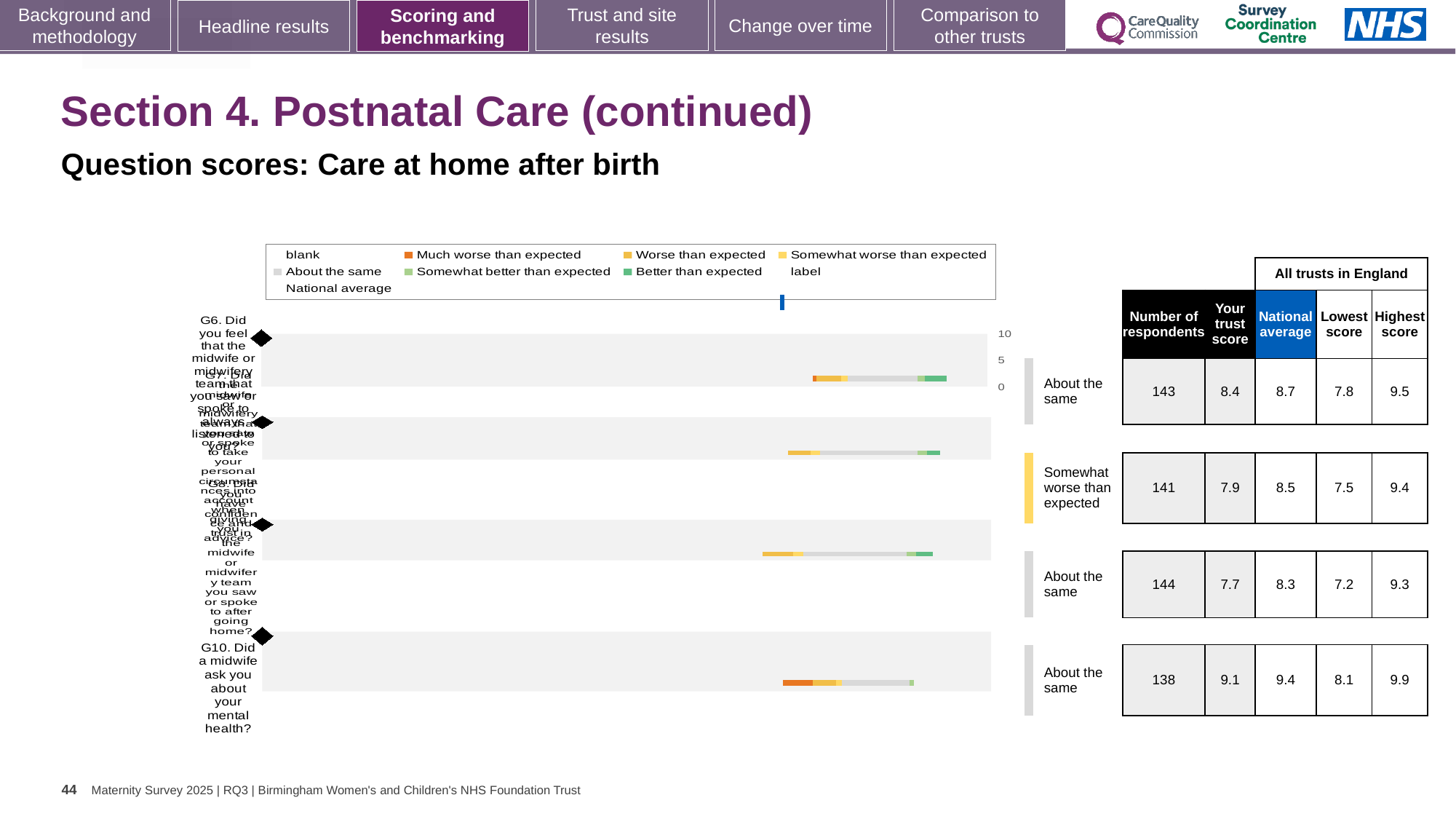
What is the maximum value shown on the chart's score axis? 10 How many respondents are listed for G10 (Did a midwife ask you about your mental health?)? 138 For G10, what is the difference between the highest score and the lowest score among all trusts in England? 1.8 Which question row has the highest trust score? G10 For G10, which is larger: the trust score or the national average? National average How many question rows (bars) are plotted in the chart? 4 What is the highest score among all trusts in England for G10 (Did a midwife ask you about your mental health?)? 9.9 What benchmark label is given to the second question row? Somewhat worse than expected What is the trust score for the first (top) question row, G6? 8.4 What is the trust score for G10 (Did a midwife ask you about your mental health?)? 9.1 What kind of chart is shown on the slide? Bar chart What is the national average score for G10 (Did a midwife ask you about your mental health?)? 9.4